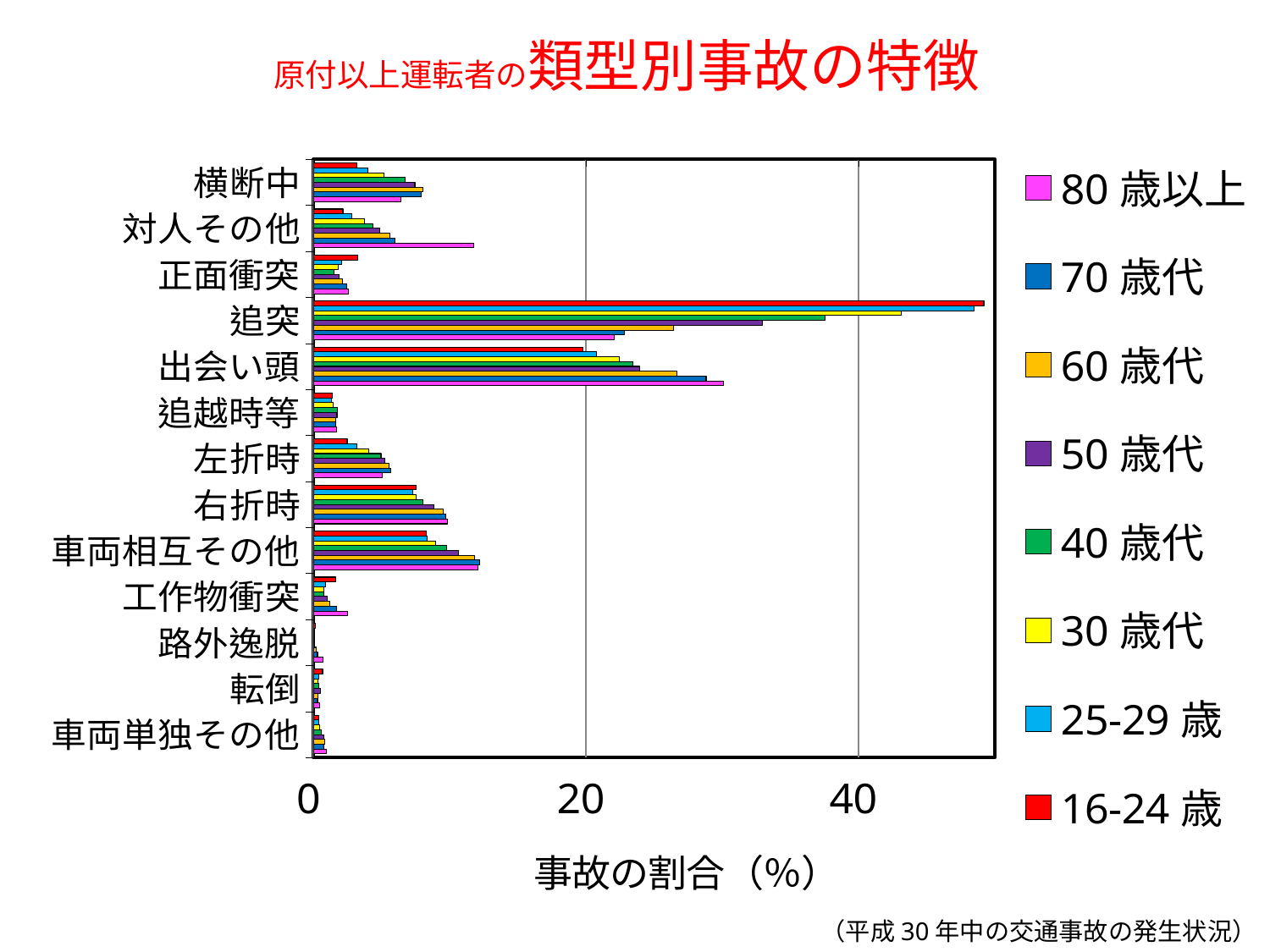
Which age-group series has the highest value for 対人その他? 80 歳以上 How many accident-type categories are listed on the vertical axis? 13 Is the value for 右折時 in the 80 歳以上 series greater or less than 20? less Is the value for 出会い頭 in the 80 歳以上 series greater or less than 20? greater Which category has the highest value for the 16-24 歳 series? 追突 Is the value for 追突 in the 16-24 歳 series greater or less than 40? greater For 横断中, which is larger: the 80 歳以上 value or the 16-24 歳 value? 80 歳以上 How many age-group series does the legend list? 8 What is the label of the horizontal axis? 事故の割合（%） What kind of chart is shown on the slide? bar chart For the 16-24 歳 series, which is larger: 追突 or 出会い頭? 追突